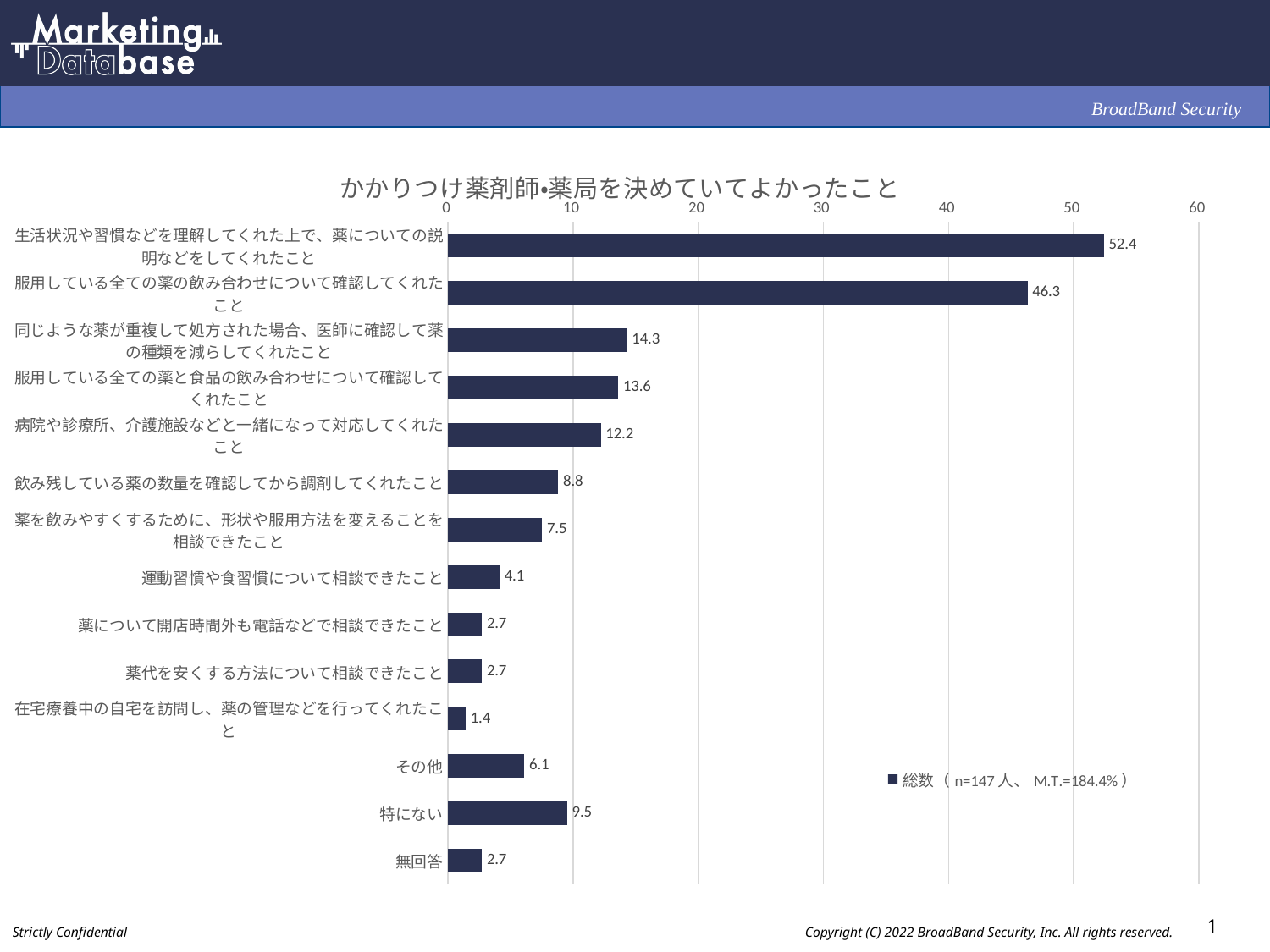
What is the value for 「服用している全ての薬の飲み合わせについて確認してくれたこと」? 46.3 What is the value for 「特にない」? 9.5 How many categories are shown in the chart? 14 Which is larger: the value for 「同じような薬が重複して処方された場合、医師に確認して薬の種類を減らしてくれたこと」 or 「病院や診療所、介護施設などと一緒になって対応してくれたこと」? 同じような薬が重複して処方された場合、医師に確認して薬の種類を減らしてくれたこと Which category has the highest value? 生活状況や習慣などを理解してくれた上で、薬についての説明などをしてくれたこと What kind of chart is shown on the slide? bar chart Which category has the lowest value? 在宅療養中の自宅を訪問し、薬の管理などを行ってくれたこと What is the value for 「その他」? 6.1 What is the difference between the values for 「生活状況や習慣などを理解してくれた上で、薬についての説明などをしてくれたこと」 and 「服用している全ての薬の飲み合わせについて確認してくれたこと」? 6.1 What is the title of the chart? かかりつけ薬剤師•薬局を決めていてよかったこと What is the value for 「生活状況や習慣などを理解してくれた上で、薬についての説明などをしてくれたこと」? 52.4 Is the value for 「飲み残している薬の数量を確認してから調剤してくれたこと」 greater or less than 10? less